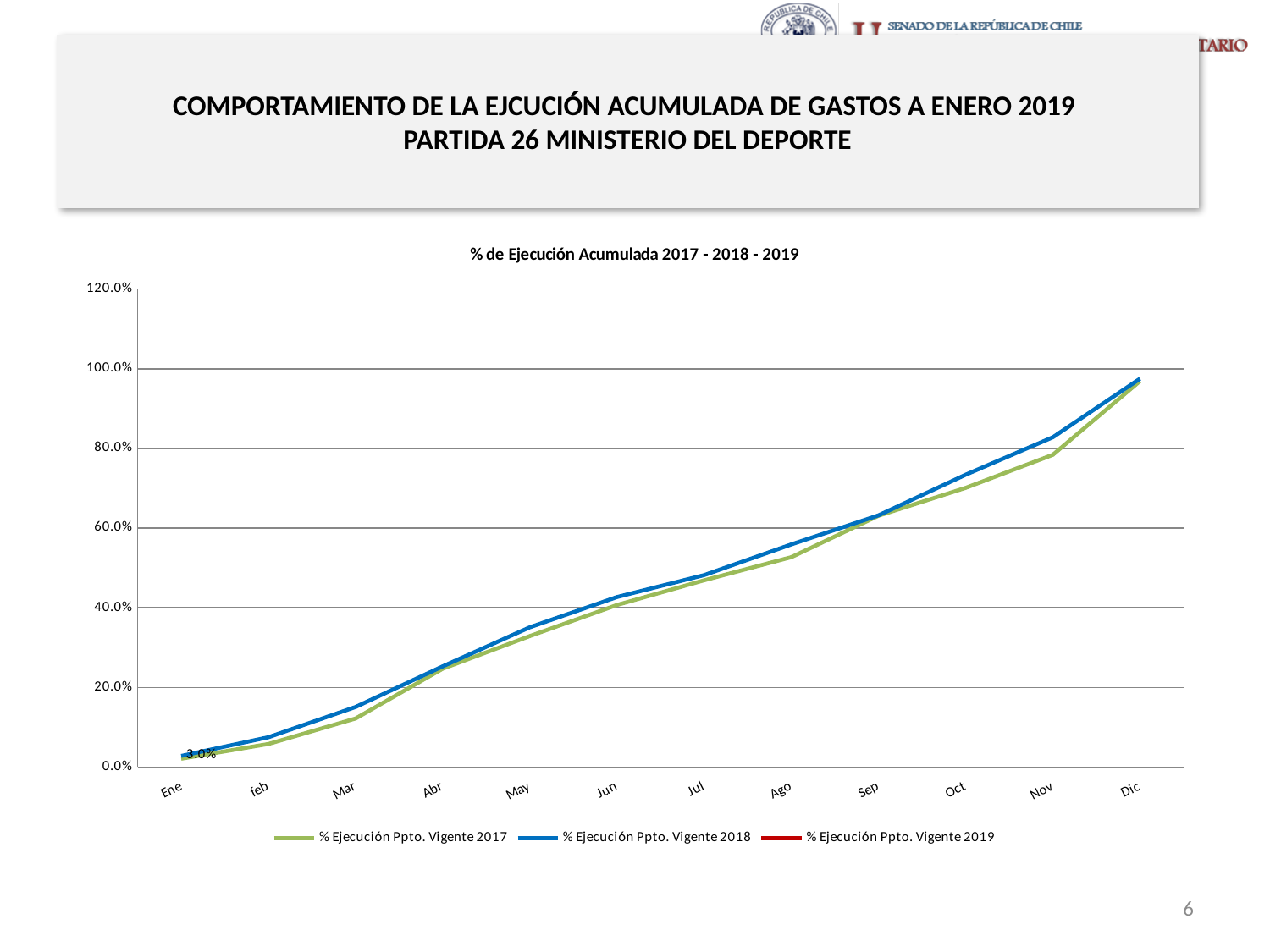
What kind of chart is shown on the slide? line chart Do the values of the % Ejecución Ppto. Vigente 2018 series rise or fall from Ene to Dic? rise How many months are shown on the x axis of the chart? 12 In Nov, which series has the higher value: % Ejecución Ppto. Vigente 2017 or % Ejecución Ppto. Vigente 2018? % Ejecución Ppto. Vigente 2018 In which month does the % Ejecución Ppto. Vigente 2017 series reach its highest value? Dic Is the value for % Ejecución Ppto. Vigente 2018 in Dic greater or less than 80.0%? greater What data label is printed at Ene on the chart? 3.0% Is the value for % Ejecución Ppto. Vigente 2017 in Mar greater or less than 20.0%? less In which month is the % Ejecución Ppto. Vigente 2018 series at its lowest value? Ene Is the value for % Ejecución Ppto. Vigente 2017 in Nov greater or less than 80.0%? less What is the title of the chart? % de Ejecución Acumulada 2017 - 2018 - 2019 How many series does the chart legend list? 3